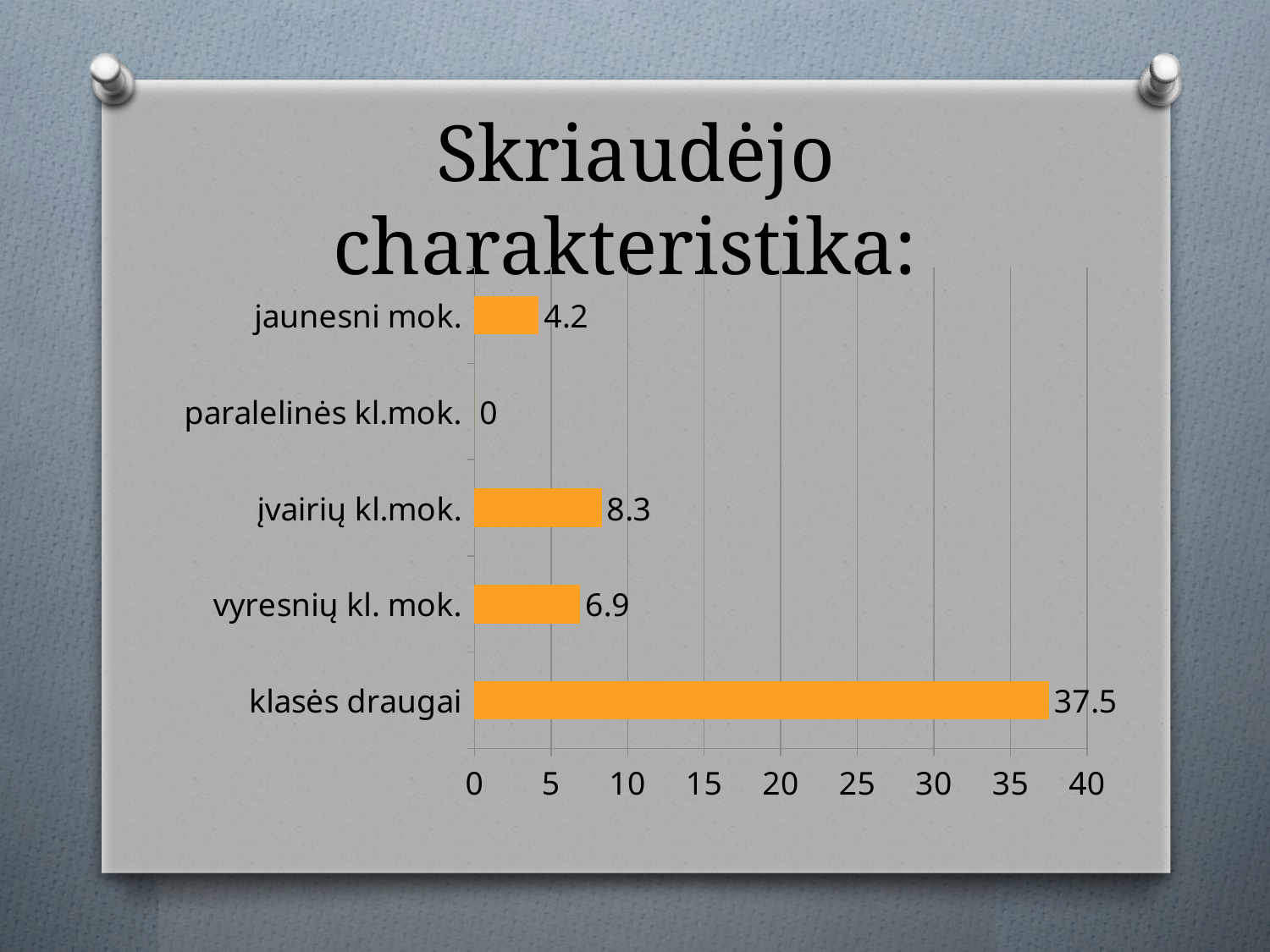
How many categories are shown in the chart? 5 What is the value for paralelinės kl.mok.? 0 Which category has the highest value? klasės draugai What is the value for jaunesni mok.? 4.2 What is the difference between the values for klasės draugai and įvairių kl.mok.? 29.2 What is the value for klasės draugai? 37.5 Which category has the lowest value? paralelinės kl.mok. What is the value for įvairių kl.mok.? 8.3 Which is larger, the value for įvairių kl.mok. or the value for vyresnių kl. mok.? įvairių kl.mok. Is the value for klasės draugai greater or less than 35? greater What kind of chart is shown on the slide? bar chart What is the title of the slide? Skriaudėjo charakteristika: